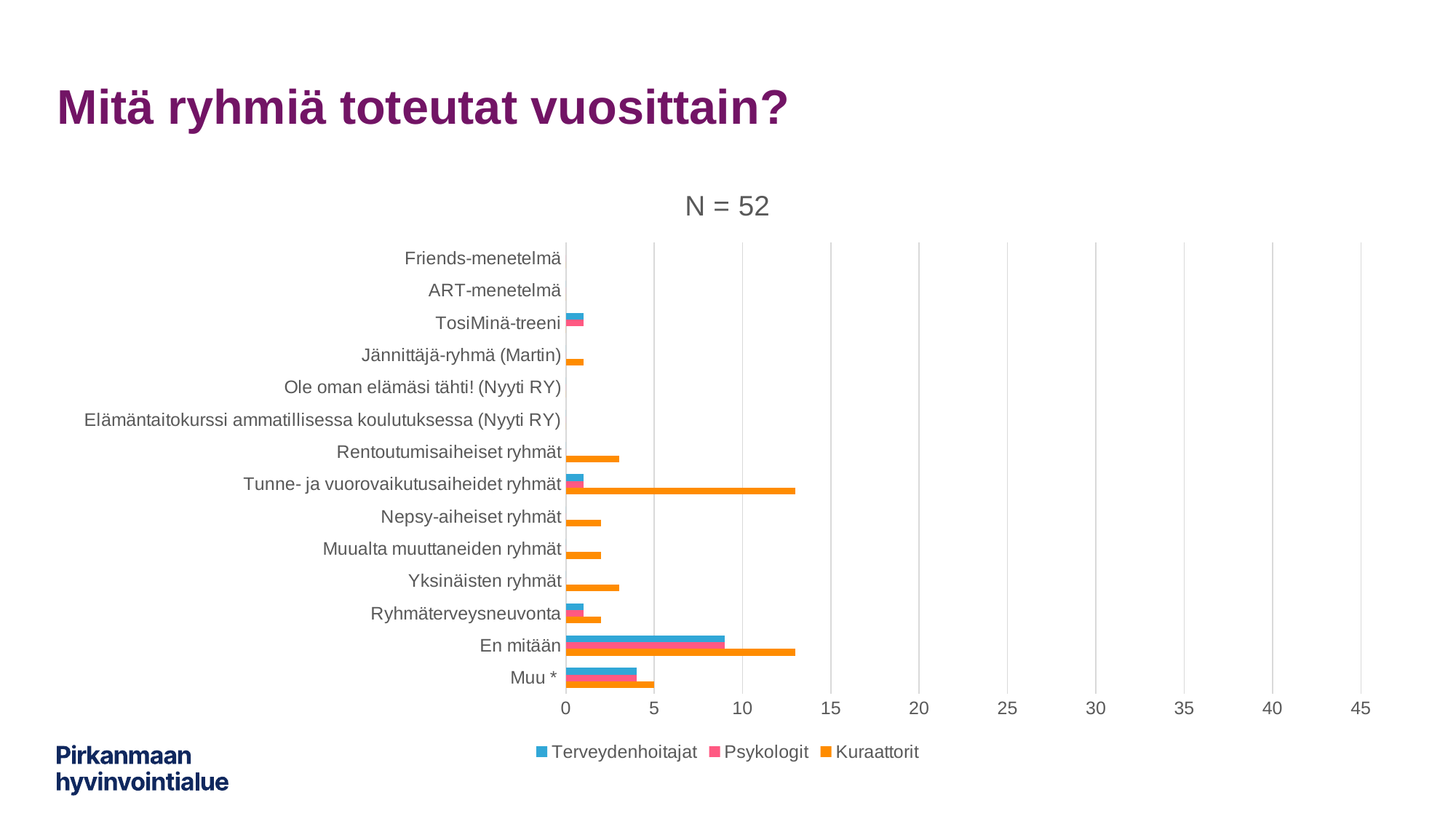
How many series does the legend list? 3 Which category has the highest Terveydenhoitajat value? En mitään Is the Terveydenhoitajat value for En mitään greater or less than 10? less Is the Kuraattorit value for Rentoutumisaiheiset ryhmät greater or less than 5? less Which is larger: the Terveydenhoitajat value for Muu * or the Terveydenhoitajat value for Ryhmäterveysneuvonta? Muu * What is the title printed above the chart? N = 52 Is the Kuraattorit value for Tunne- ja vuorovaikutusaiheidet ryhmät greater or less than 10? greater How many categories are shown on the vertical axis of the chart? 14 Which category has the highest Psykologit value? En mitään What kind of chart is shown on the slide? bar chart What is the Kuraattorit value for Muu *? 5 Which series is shown in orange in the legend? Kuraattorit